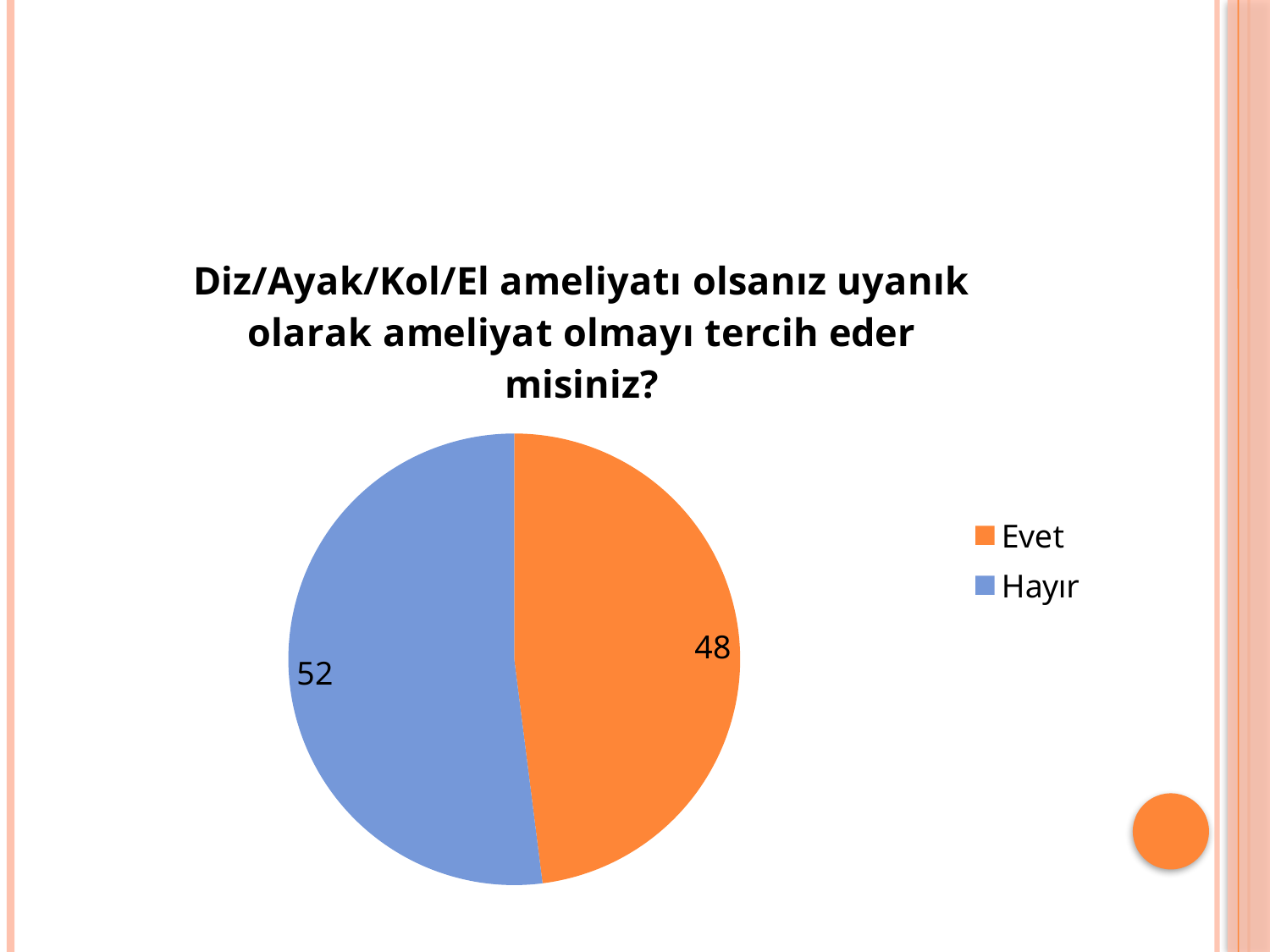
What is the value for Evet? 48 Which is larger, the value for Evet or the value for Hayır? Hayır What is the difference between the values for Hayır and Evet? 4 Which category has the smallest slice? Evet What is the value for Hayır? 52 What colour is the Hayır slice? blue What share of the pie does the Evet slice represent? 48% What is the total of the two slices? 100 What kind of chart is shown on the slide? pie chart How many entries does the legend list? 2 Which category has the largest slice? Hayır How many categories does the pie chart have? 2